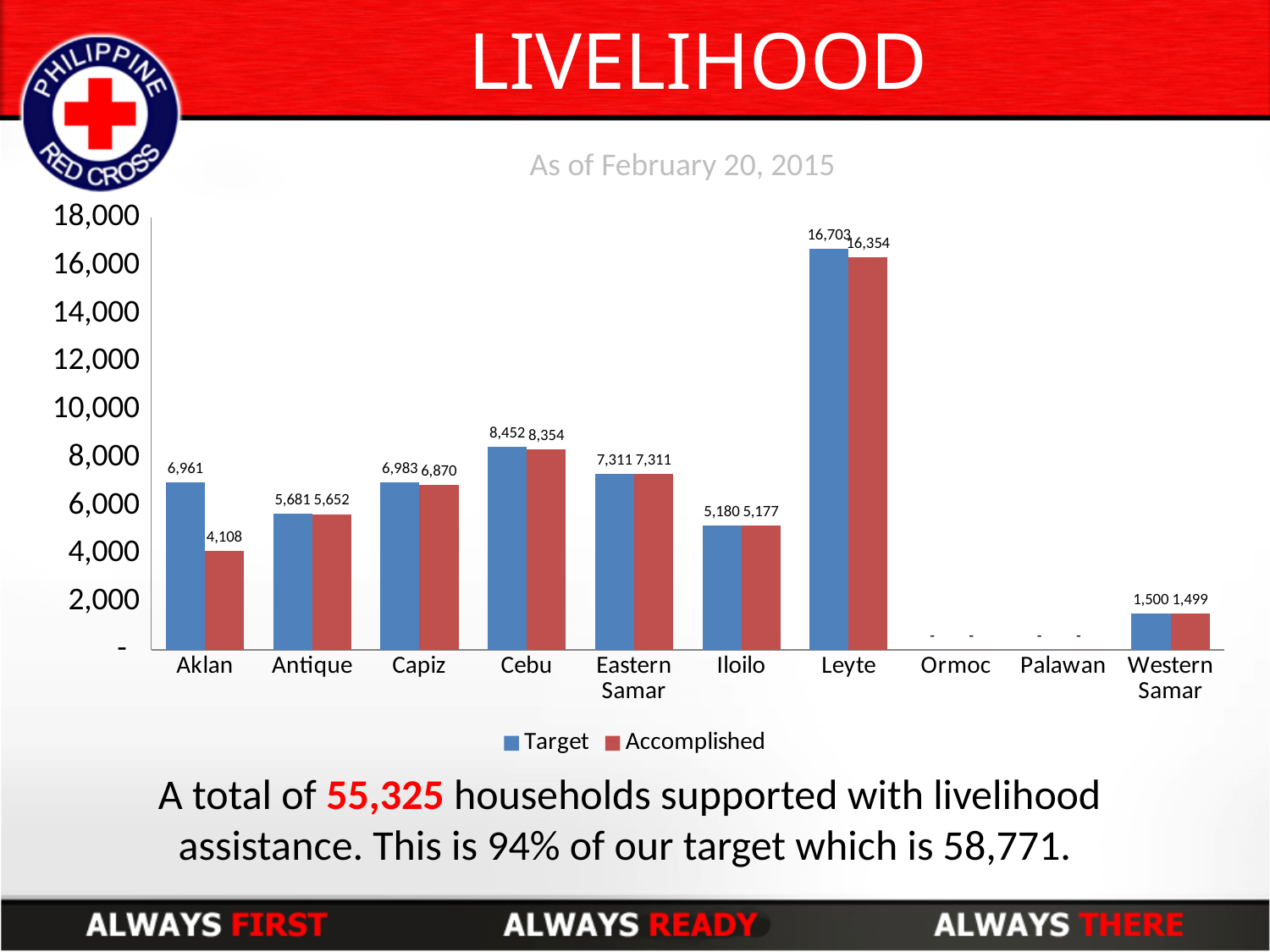
Among the categories with a plotted Accomplished bar, which has the lowest Accomplished value? Western Samar Is the Target value for Leyte greater or less than 16,000? greater What is the Accomplished value for Leyte? 16,354 How many categories are shown on the x axis? 10 What is the Accomplished value for Western Samar? 1,499 What kind of chart is shown on the slide? bar chart What is the Target value for Aklan? 6,961 Which category has the highest Target value? Leyte What is the difference between the Target and Accomplished values for Aklan? 2,853 How many series does the legend list? 2 Which is larger, the Target value for Cebu or the Target value for Capiz? Cebu